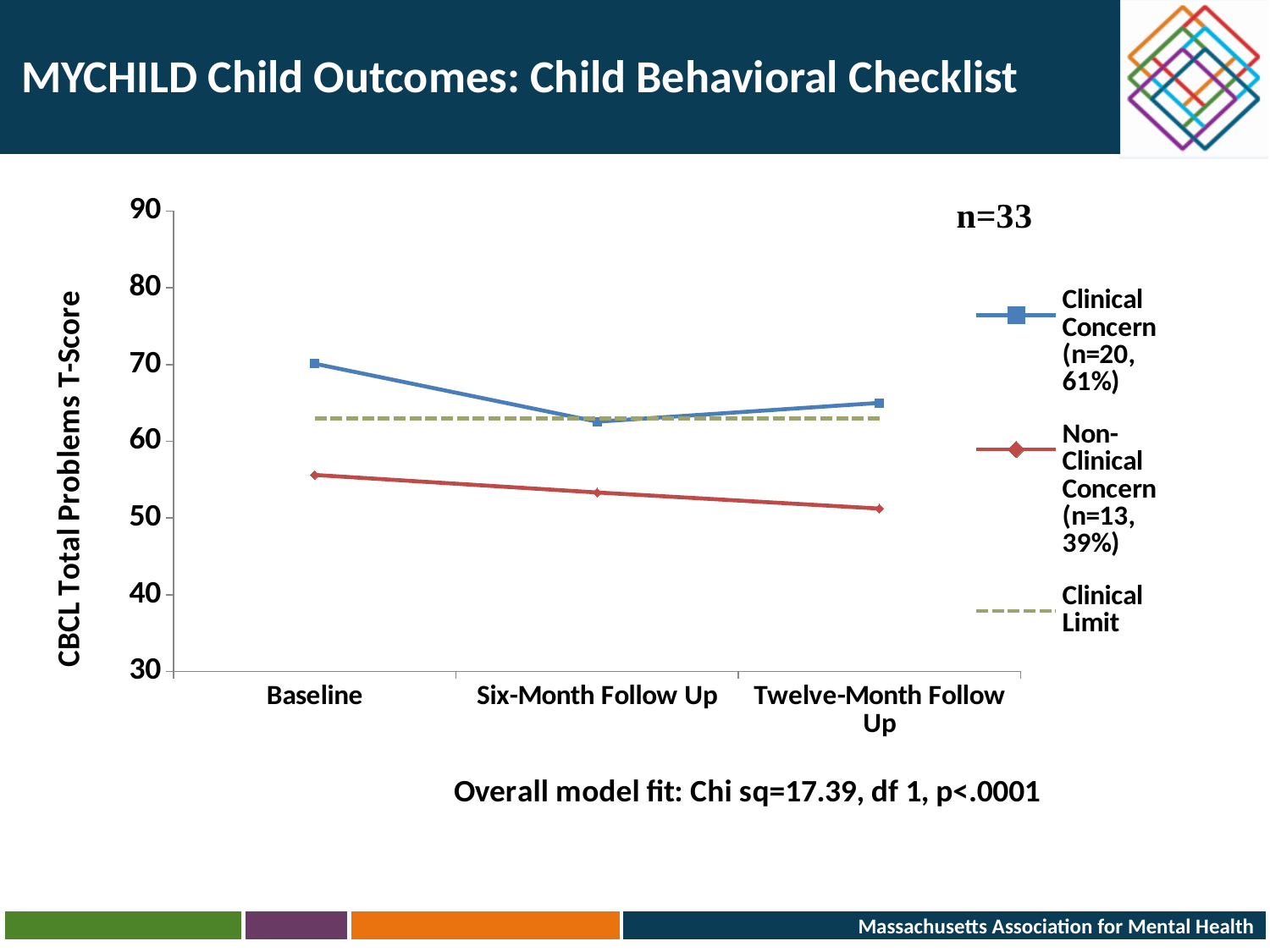
How many time points are shown on the x axis? 3 What kind of chart is shown on the slide? line chart Is the Clinical Concern value at Baseline greater or less than 60? greater What sample size is shown for the Clinical Concern group in the legend? n=20, 61% At Baseline, which series has the higher value: Clinical Concern or Non-Clinical Concern? Clinical Concern Is the Non-Clinical Concern value at Twelve-Month Follow Up greater or less than 60? less At which time point is the Non-Clinical Concern value lowest? Twelve-Month Follow Up How many series does the legend list? 3 Is the Clinical Concern value at Six-Month Follow Up greater or less than 70? less Does the Non-Clinical Concern line rise or fall from Baseline to Twelve-Month Follow Up? fall What is the title of the y axis? CBCL Total Problems T-Score At which time point is the Clinical Concern value highest? Baseline